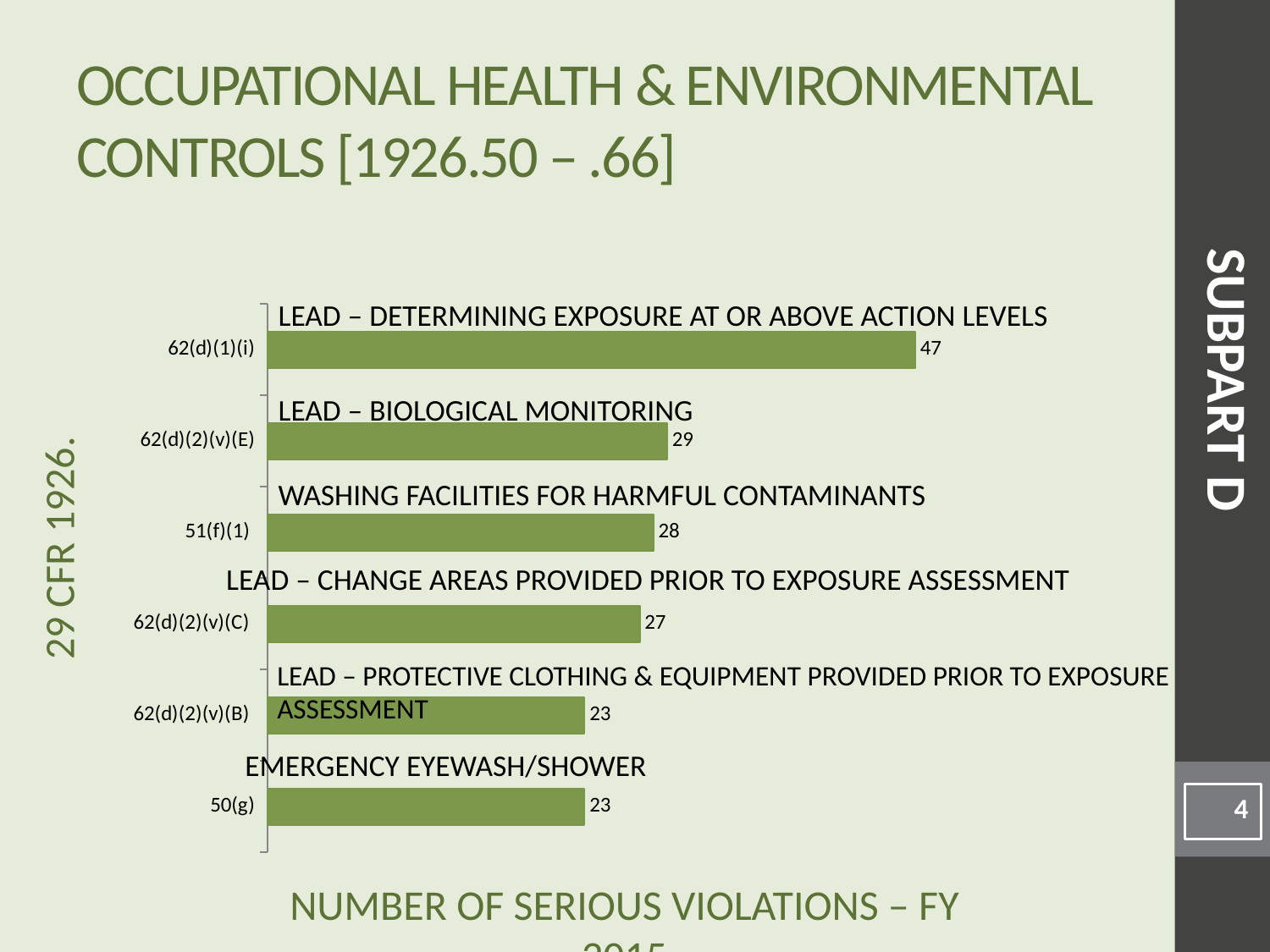
What is the number of serious violations for 62(d)(2)(v)(C), Lead – Change Areas Provided Prior to Exposure Assessment? 27 What is the number of serious violations for 62(d)(1)(i), Lead – Determining Exposure at or Above Action Levels? 47 What is the difference in serious violations between 62(d)(1)(i) and 62(d)(2)(v)(E)? 18 Which has more serious violations, 62(d)(2)(v)(E) or 62(d)(2)(v)(B)? 62(d)(2)(v)(E) What is the number of serious violations for 51(f)(1), Washing Facilities for Harmful Contaminants? 28 What kind of chart is shown on the slide? Bar chart What is the number of serious violations for 50(g), Emergency Eyewash/Shower? 23 How many standards are shown in the chart? 6 What is the difference in serious violations between 51(f)(1) and 62(d)(2)(v)(C)? 1 Which standard has the highest number of serious violations? 62(d)(1)(i) What is the number of serious violations for 62(d)(2)(v)(E), Lead – Biological Monitoring? 29